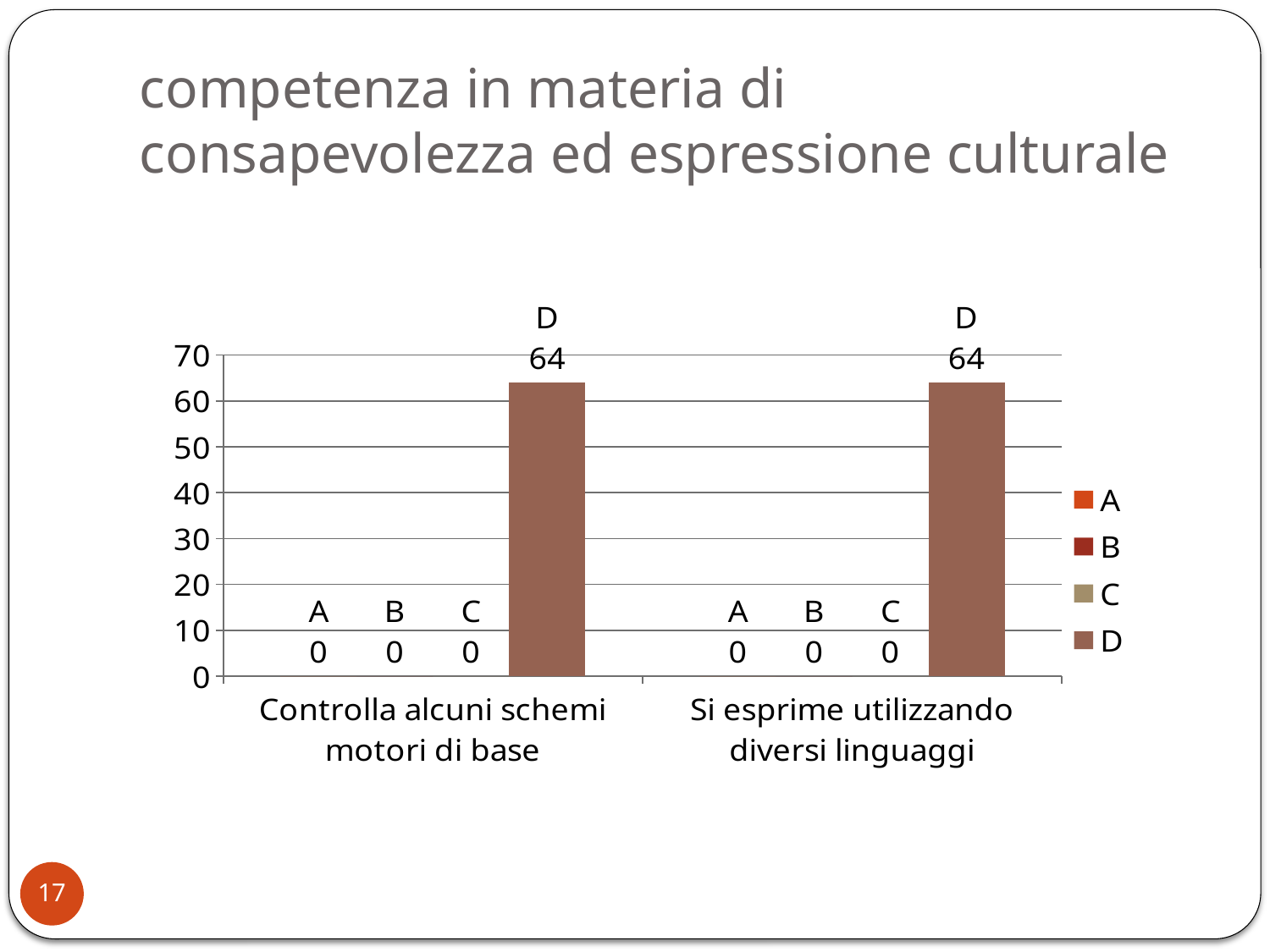
What is the value of series D for "Si esprime utilizzando diversi linguaggi"? 64 What is the value of series A for "Controlla alcuni schemi motori di base"? 0 What is the total of series A, B, C and D for "Si esprime utilizzando diversi linguaggi"? 64 What is the value of series C for "Si esprime utilizzando diversi linguaggi"? 0 What is the value of series D for "Controlla alcuni schemi motori di base"? 64 What kind of chart is shown on the slide? bar chart Is the value of series D for "Controlla alcuni schemi motori di base" greater or less than 60? greater Which series has the highest value for "Si esprime utilizzando diversi linguaggi"? D How many categories are shown on the x axis? 2 What is the highest value shown on the vertical axis? 70 What is the difference between series D and series B for "Controlla alcuni schemi motori di base"? 64 How many series does the legend list? 4